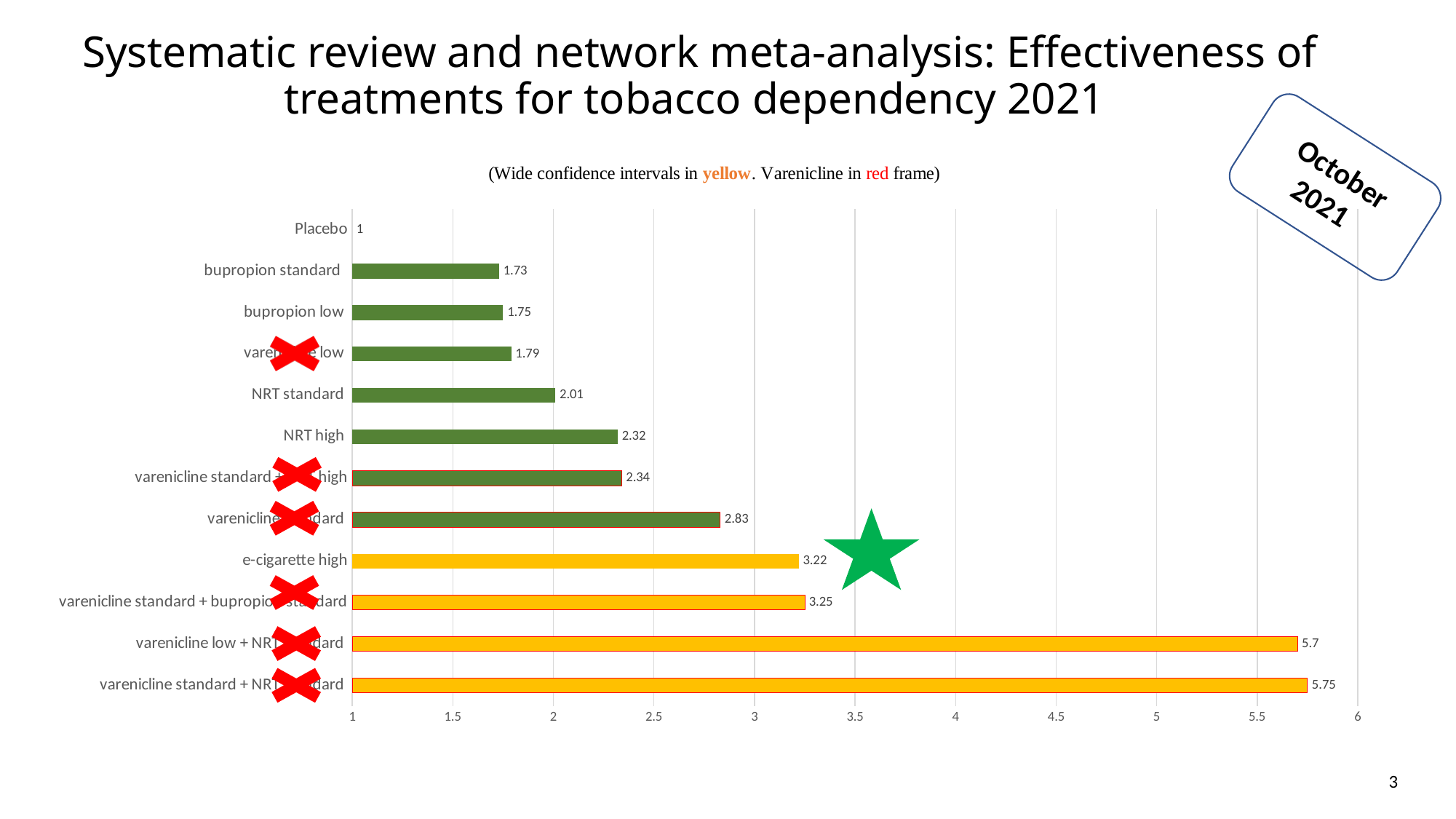
What type of chart is shown on the slide? bar chart Which has a larger value, NRT high or bupropion low? NRT high What is the value for e-cigarette high? 3.22 Is the value for e-cigarette high greater or less than 3? greater How many categories are plotted on the chart? 12 What is the highest value shown on the chart? 5.75 Which category has the lowest value? Placebo According to the note above the chart, what colour marks wide confidence intervals? yellow What is the value for NRT standard? 2.01 What is the difference between the values for NRT high and NRT standard? 0.31 What is the value for bupropion standard? 1.73 What is the value for NRT high? 2.32